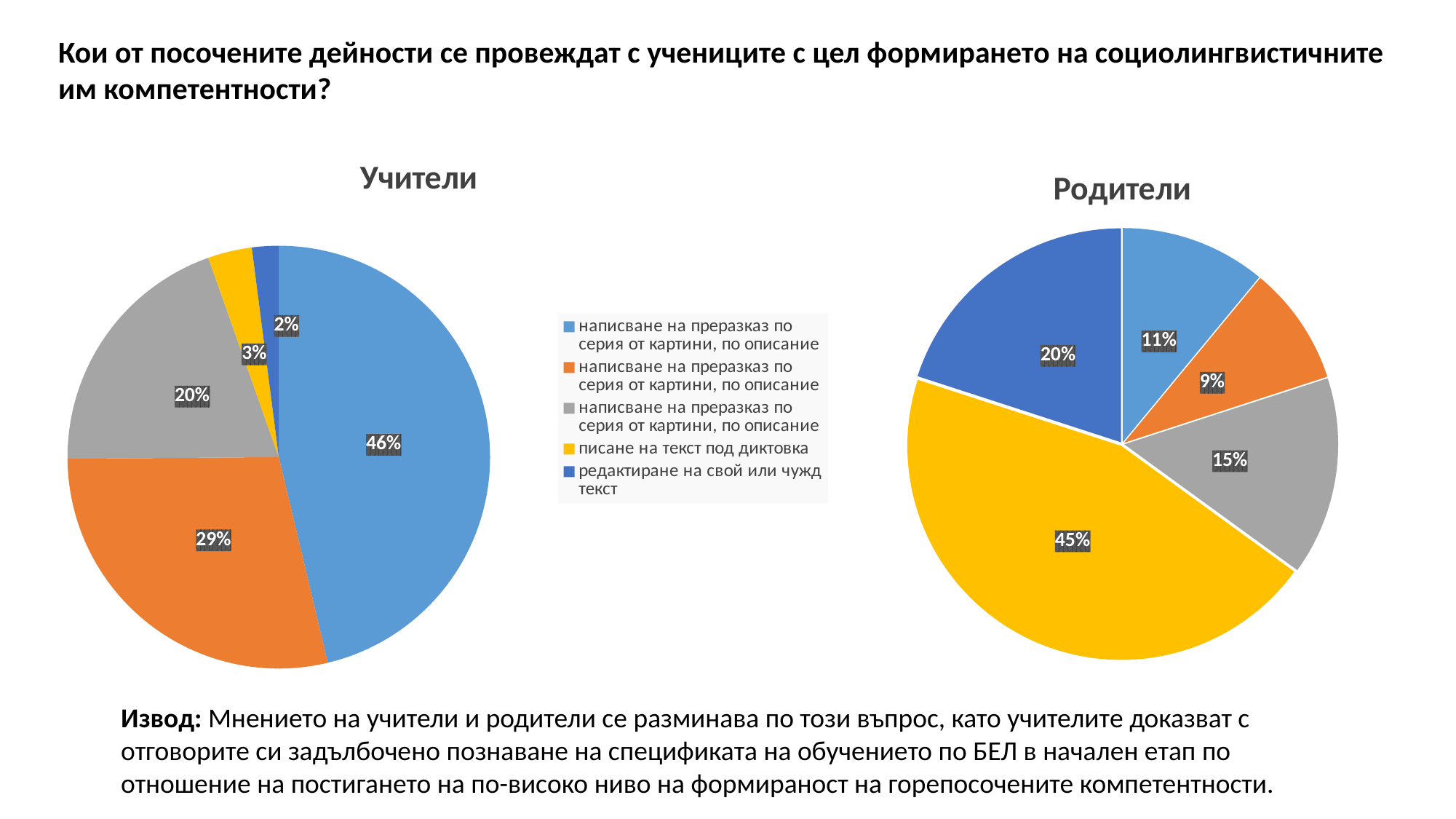
In the "Родители" chart, what is the smallest percentage shown? 9% How many slices does the "Родители" pie chart have? 5 In the "Родители" chart, which category has the largest slice? писане на текст под диктовка In the "Учители" chart, which category has the smallest slice? редактиране на свой или чужд текст In the "Учители" chart, what share does "писане на текст под диктовка" have? 3% In the "Родители" chart, what share does "редактиране на свой или чужд текст" have? 20% In the "Учители" chart, what share does "редактиране на свой или чужд текст" have? 2% What kind of charts are shown on the slide? Pie charts What is the difference between the share of "писане на текст под диктовка" in the "Родители" chart and in the "Учители" chart? 42% In the "Родители" chart, what share does "писане на текст под диктовка" have? 45% Which chart shows a larger share for "редактиране на свой или чужд текст", "Учители" or "Родители"? Родители In the "Учители" chart, what is the largest percentage shown? 46%